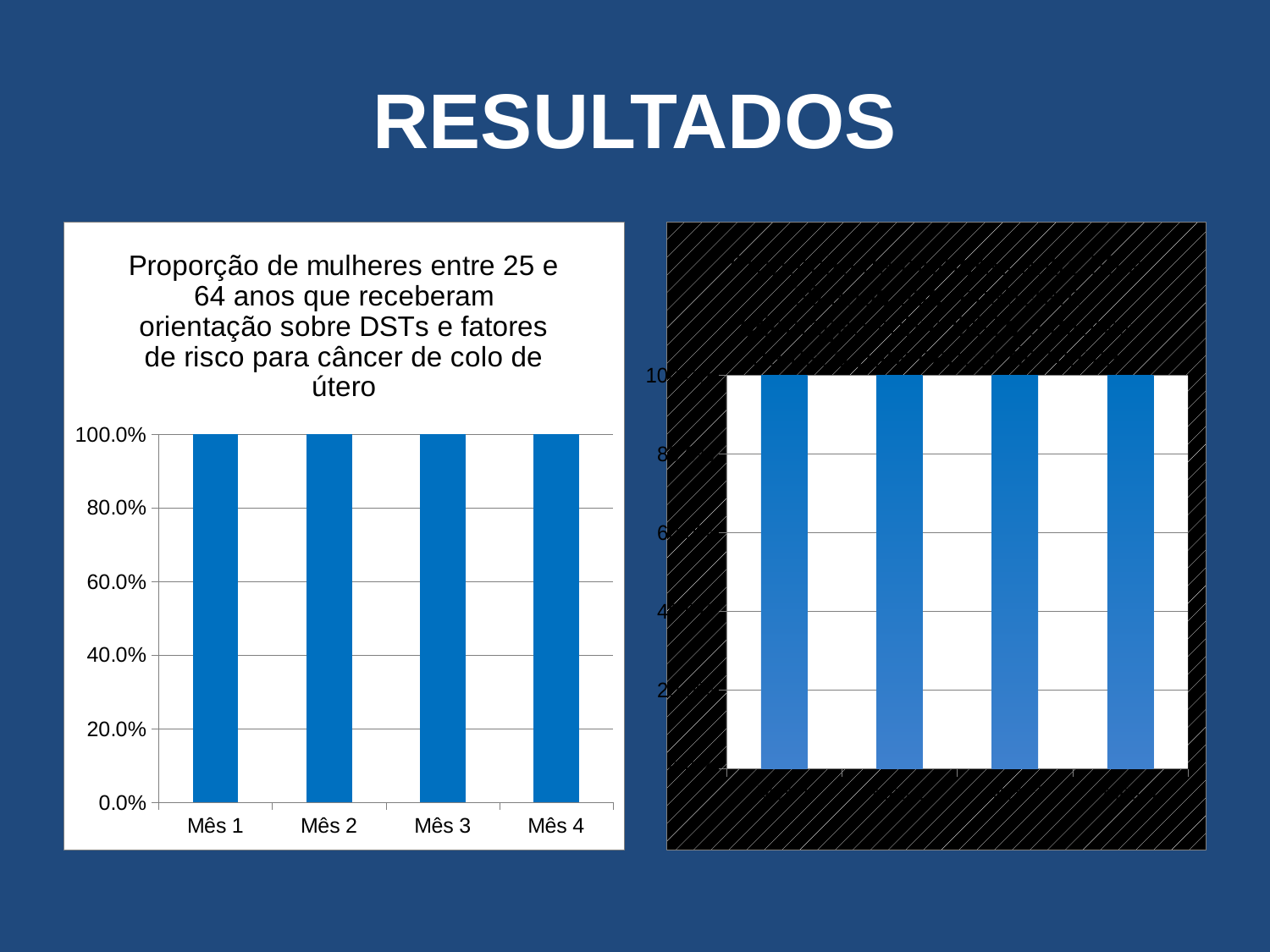
On the left chart, what is the value for Mês 1? 100.0% How many categories are shown on the left chart? 4 How many bars are shown on the right chart? 4 What is the title of the left chart? Proporção de mulheres entre 25 e 64 anos que receberam orientação sobre DSTs e fatores de risco para câncer de colo de útero On the left chart, do the values rise, fall or stay the same from Mês 1 to Mês 4? stay the same On the left chart, is the value for Mês 2 greater or less than 80.0%? greater What is the highest value shown on the y axis of the left chart? 100.0% What kind of chart is the right chart? bar chart What kind of chart is the left chart? bar chart On the left chart, what is the value for Mês 3? 100.0% On the left chart, what is the value for Mês 4? 100.0% On the left chart, what is the difference between the values for Mês 2 and Mês 4? 0.0%